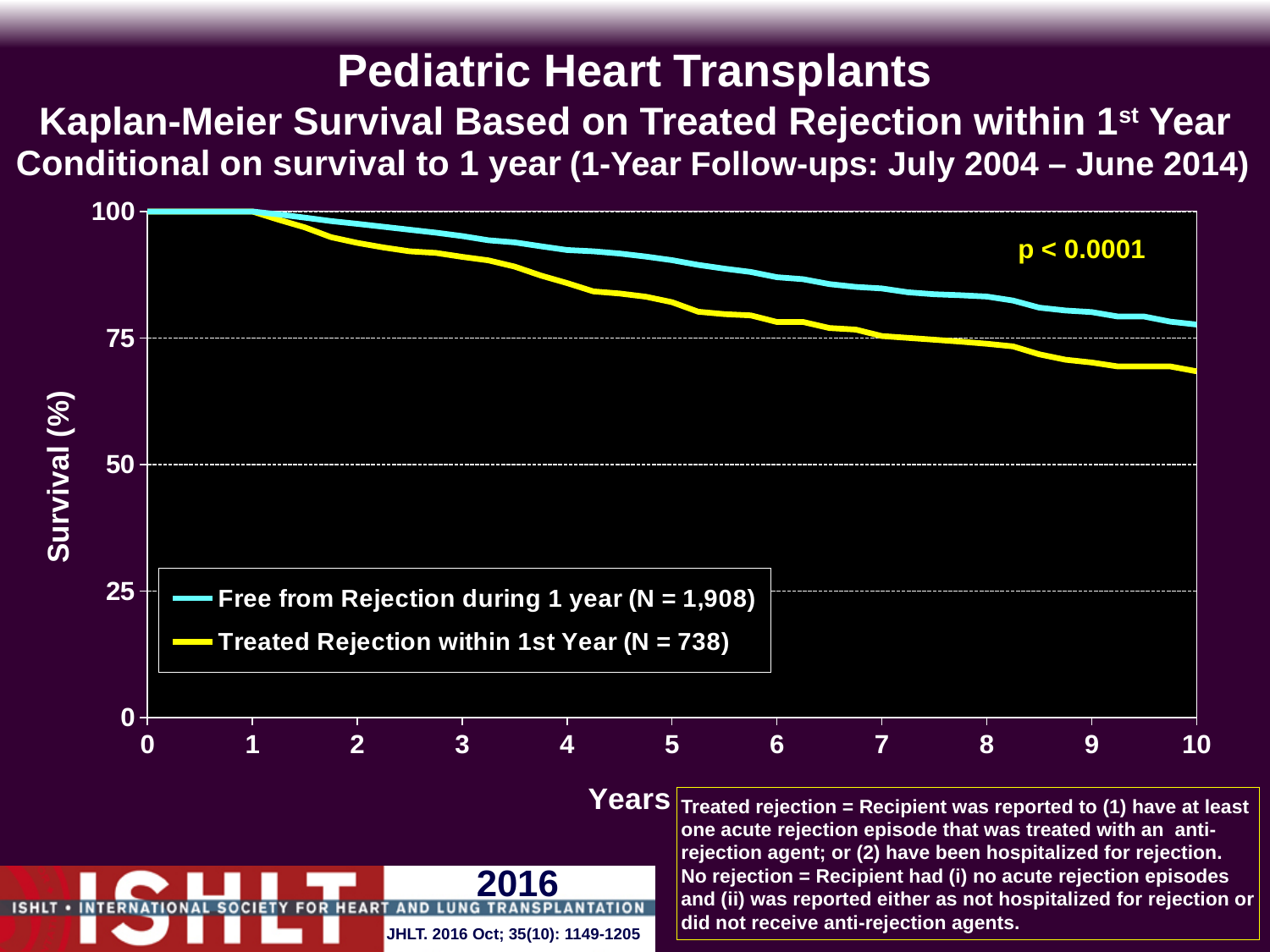
Is the survival value for the 'Treated Rejection within 1st Year' group at 10 years greater or less than 75? less Do the survival curves rise or fall as years increase? fall What is the label of the y axis? Survival (%) What is the maximum value shown on the x axis (Years)? 10 Is the survival value for the 'Treated Rejection within 1st Year' group at 5 years greater or less than 75? greater Is the survival value for the 'Free from Rejection during 1 year' group at 10 years greater or less than 75? greater How many series does the legend list? 2 What kind of chart is shown on the slide? line chart What is the N for the 'Treated Rejection within 1st Year' group shown in the legend? 738 Which group has higher survival at 10 years, 'Free from Rejection during 1 year' or 'Treated Rejection within 1st Year'? Free from Rejection during 1 year